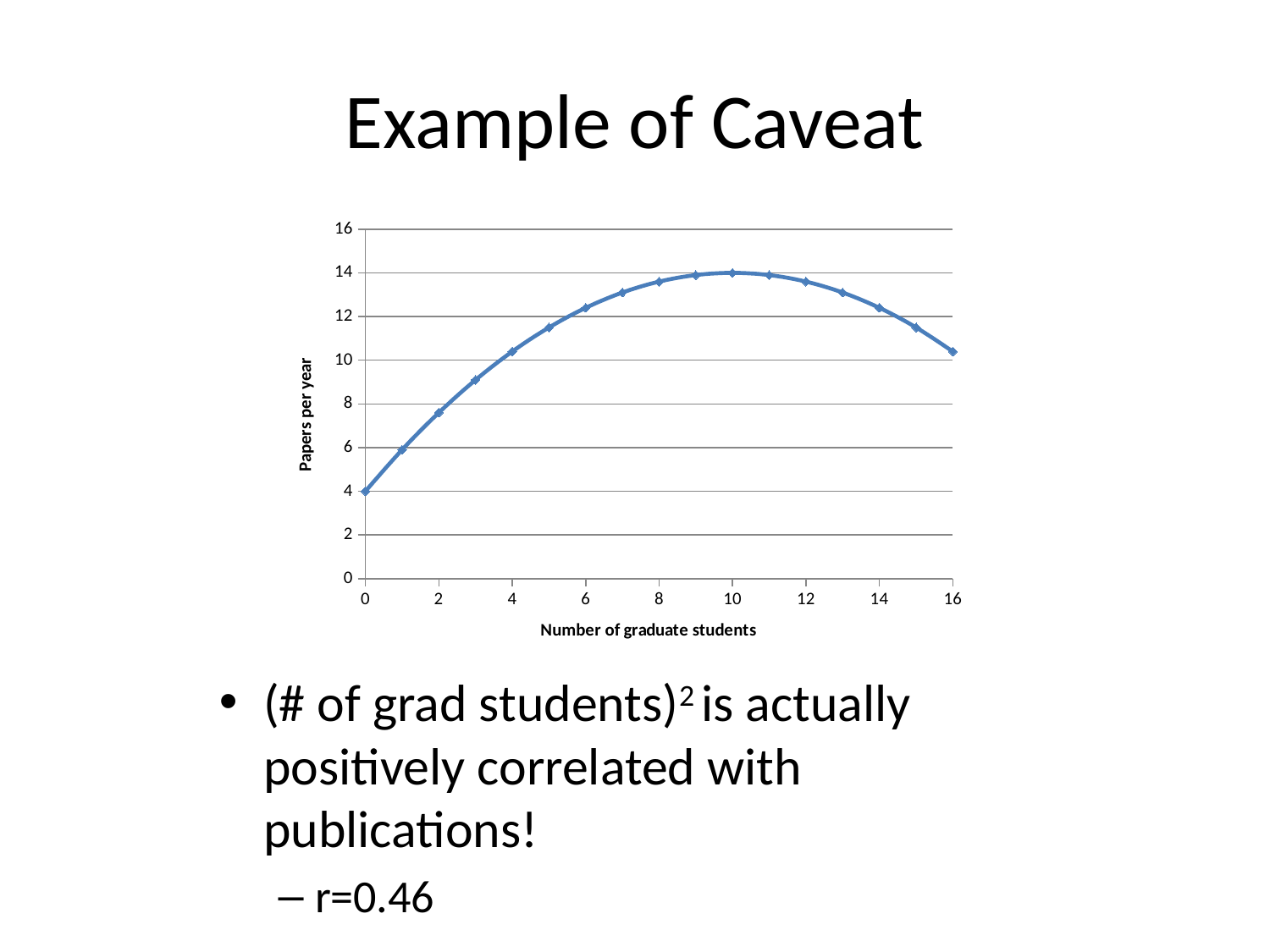
At which number of graduate students is Papers per year lowest? 0 What is the value of Papers per year when the number of graduate students is 0? 4 How many data points are plotted on the line? 17 How does Papers per year change as the number of graduate students increases from 0 to 16? rises until 10, then falls Which has more Papers per year: 2 graduate students or 14 graduate students? 14 graduate students Is the value for 5 graduate students greater or less than 10? greater What is the difference in Papers per year between 10 graduate students and 0 graduate students? 10 Is the value for 3 graduate students greater or less than 8? greater What kind of chart is shown on the slide? line chart Is the value for 8 graduate students greater or less than 12? greater What is the value of Papers per year when the number of graduate students is 10? 14 At which number of graduate students is Papers per year highest? 10